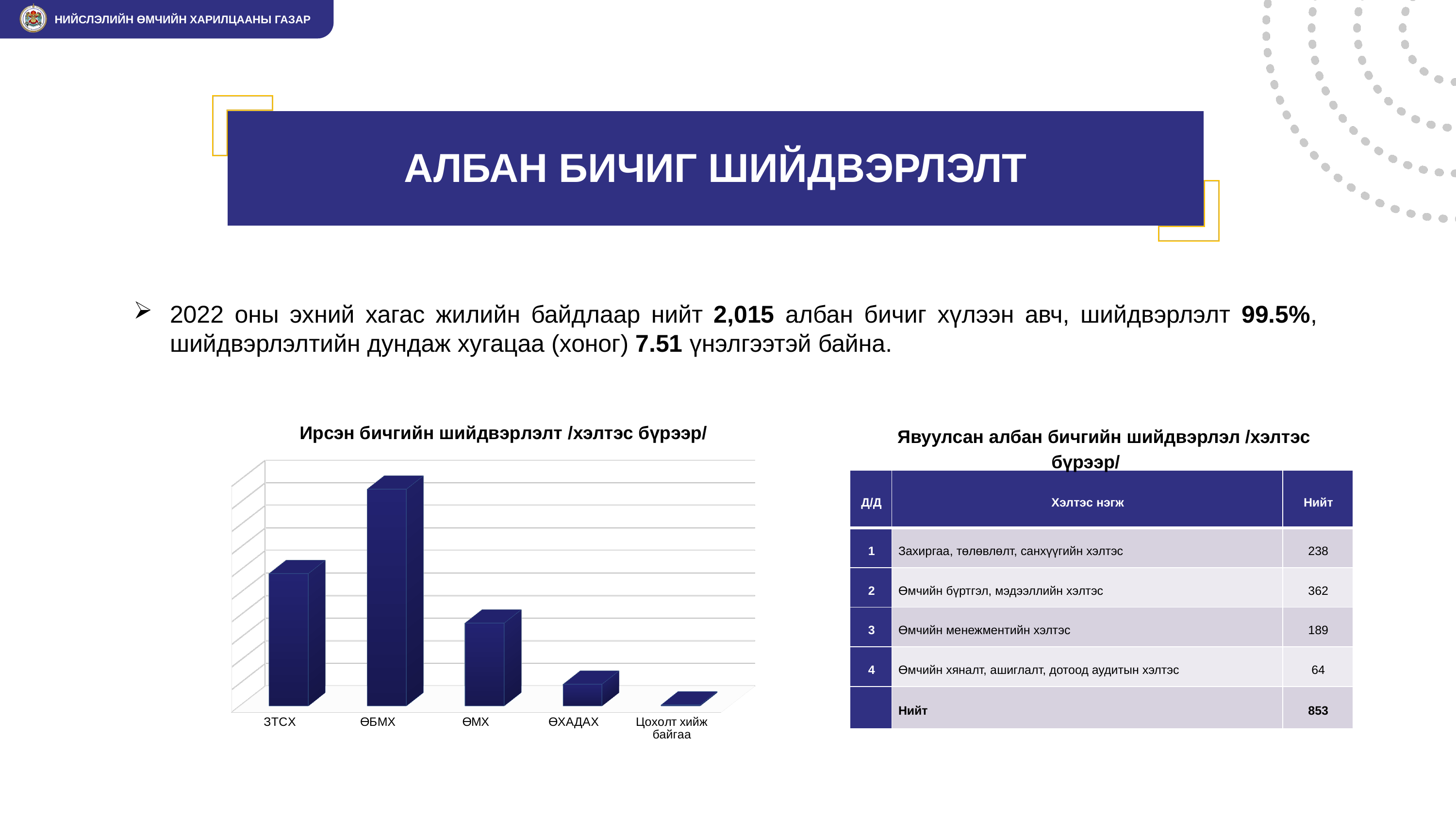
Which is larger in the chart, the bar for ӨБМХ or the bar for ЗТСХ? ӨБМХ Do the bar values rise or fall from ӨБМХ to Цохолт хийж байгаа along the x axis? Fall How many categories are shown on the x axis of the bar chart? 5 Which category has the highest bar in the chart? ӨБМХ What is the label of the first category on the x axis of the chart? ЗТСХ What is the title of the bar chart? Ирсэн бичгийн шийдвэрлэлт /хэлтэс бүрээр/ Which is larger in the chart, the bar for ӨХАДАХ or the bar for ӨМХ? ӨМХ Which category has the lowest bar in the chart? Цохолт хийж байгаа Which is larger in the chart, the bar for ӨХАДАХ or the bar for Цохолт хийж байгаа? ӨХАДАХ What kind of chart is shown on the slide? Bar chart Which category has the second highest bar in the chart? ЗТСХ